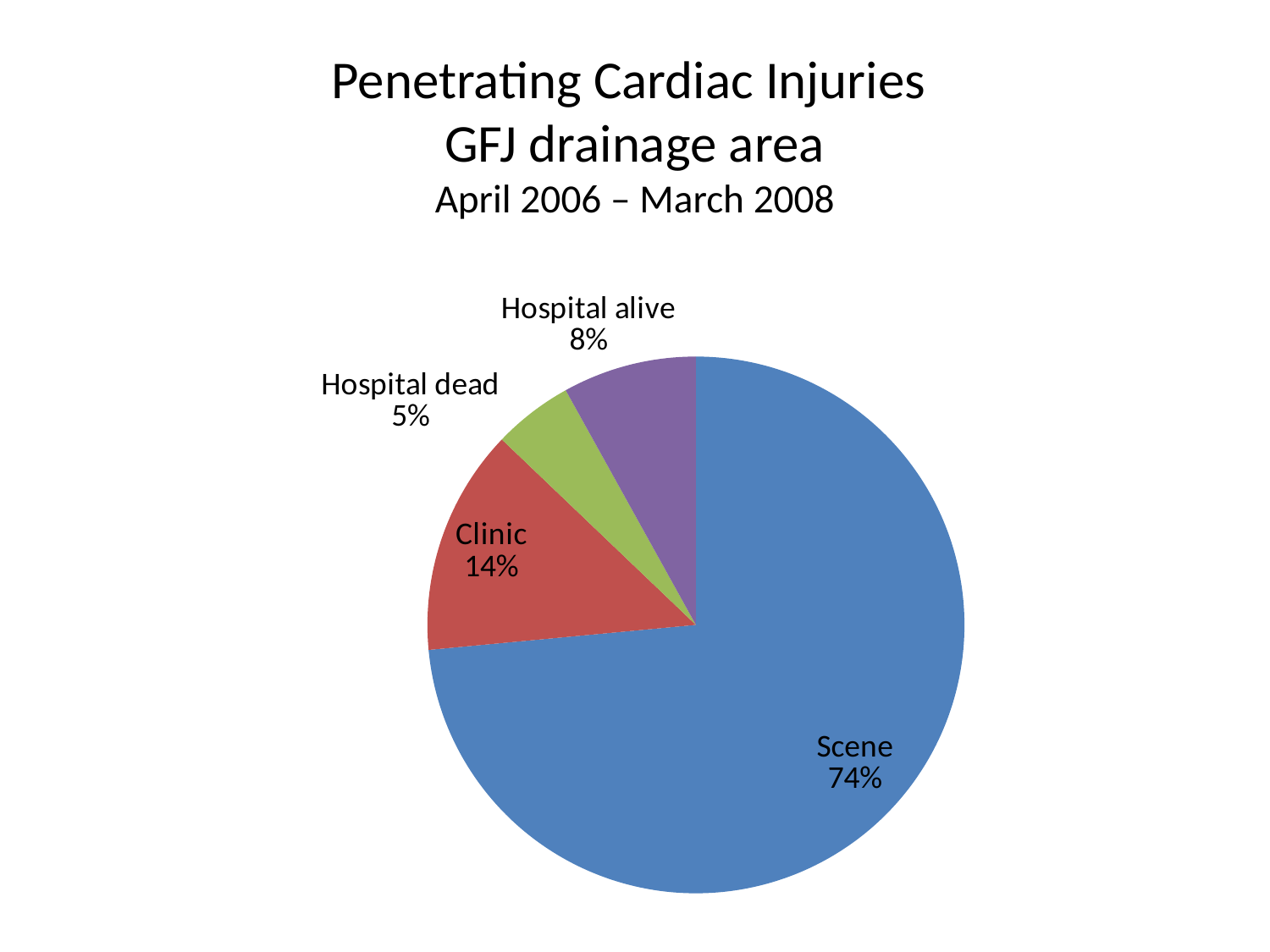
What time period does the chart title state? April 2006 – March 2008 What is the difference in percentage points between the Scene slice and the Clinic slice? 60 How many slices does the pie chart have? 4 What is the difference in percentage points between the Hospital alive slice and the Hospital dead slice? 3 What share of the pie does the Clinic slice represent? 14% Which slice is larger, Clinic or Hospital alive? Clinic What share of the pie does the Hospital alive slice represent? 8% What kind of chart is shown on the slide? pie chart Which category has the largest slice of the pie? Scene Which category has the smallest slice of the pie? Hospital dead What share of the pie does the Hospital dead slice represent? 5%